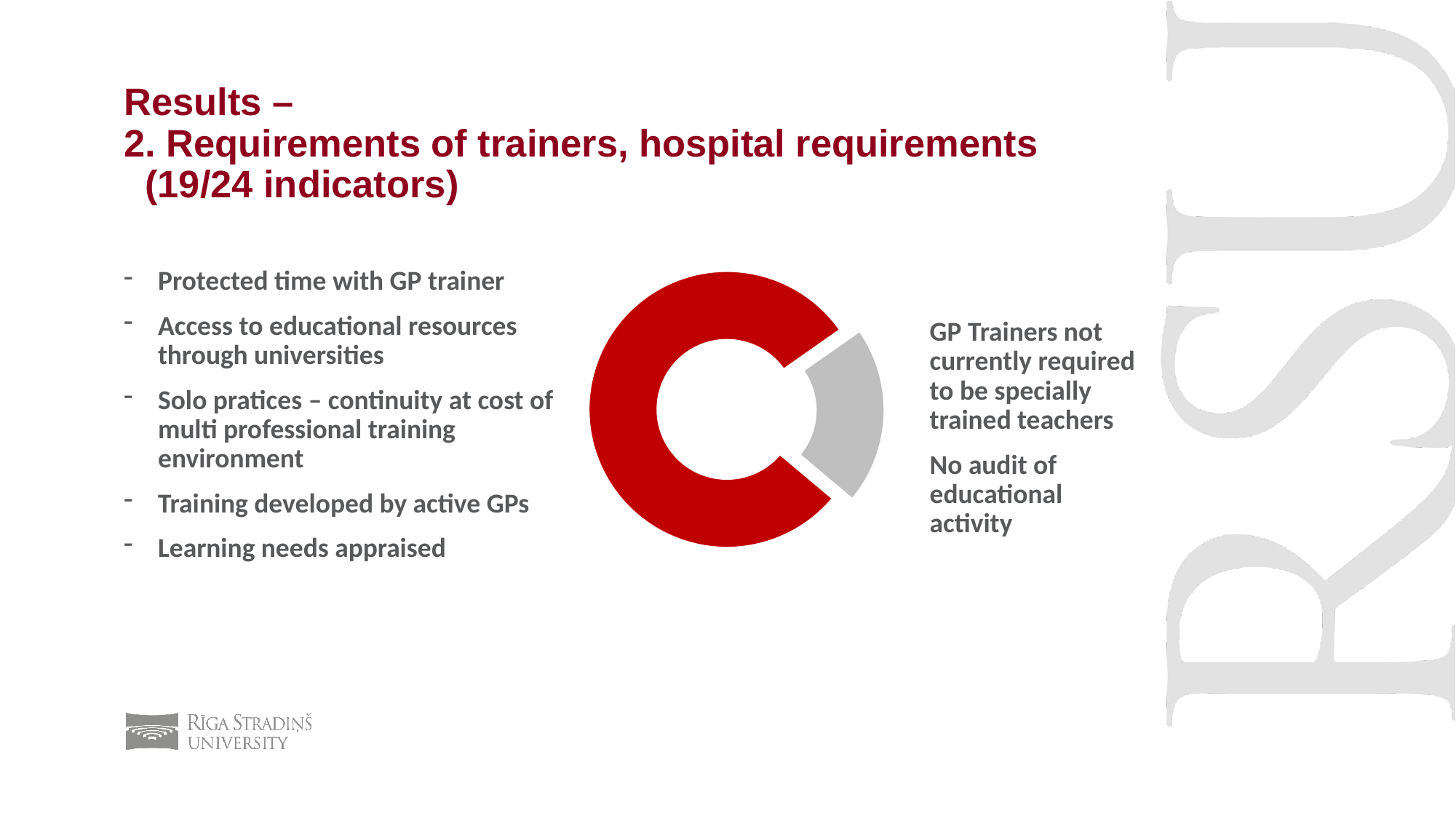
Which colour slice takes up the smallest share of the doughnut chart? Grey What kind of chart is shown on the slide? Doughnut chart Does the doughnut chart display a legend? No Which slice of the doughnut chart is larger, the red one or the grey one? The red one Which colour slice takes up the largest share of the doughnut chart? Red How many slices does the doughnut chart have? 2 Does the red slice of the doughnut chart cover more or less than half of the ring? More What two colours are used for the slices of the doughnut chart? Red and grey Does the grey slice of the doughnut chart cover more or less than half of the ring? Less